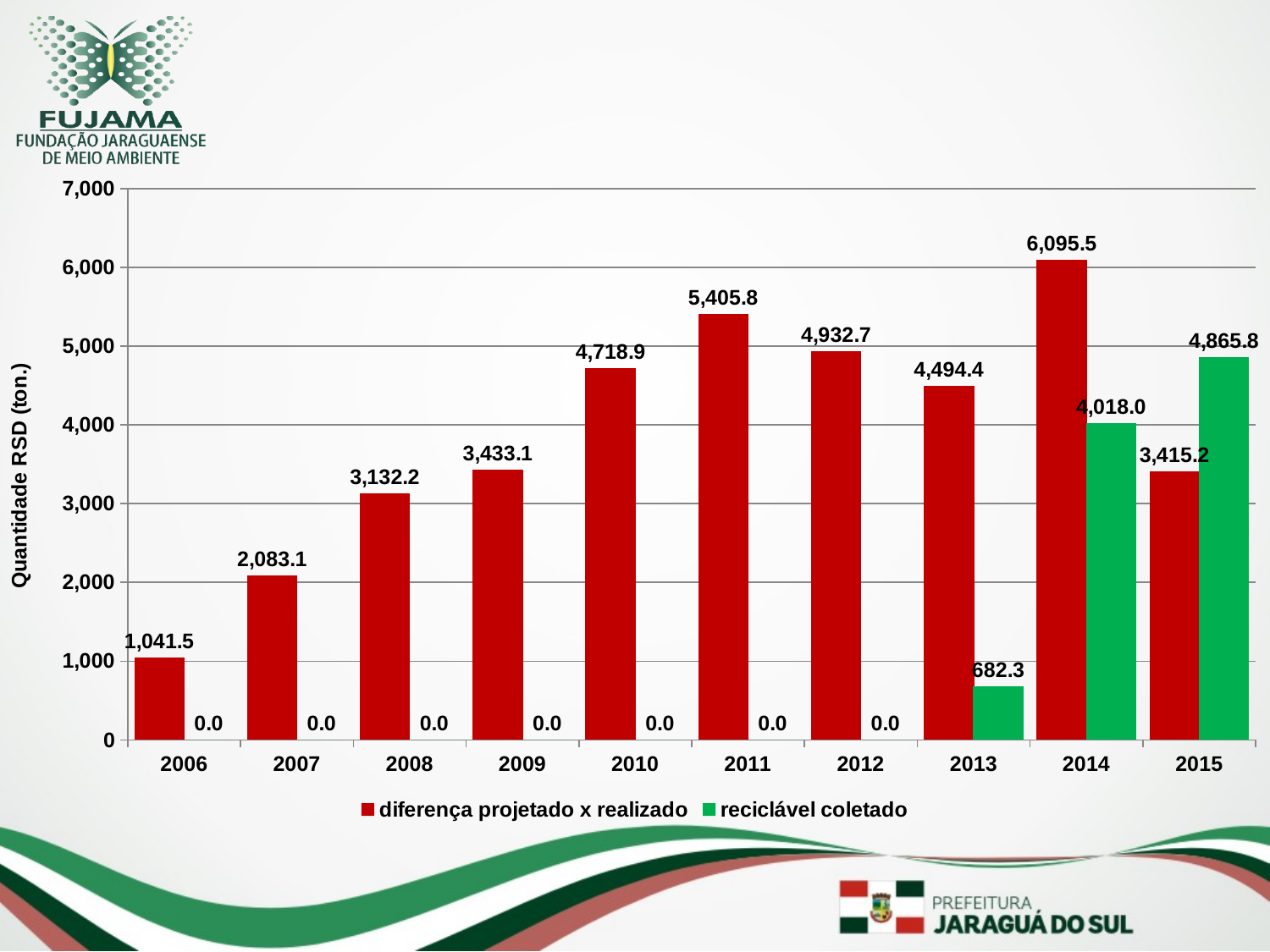
How many series does the legend list? 2 What is the difference between "reciclável coletado" and "diferença projetado x realizado" in 2015? 1,450.6 Is the value of "diferença projetado x realizado" for 2011 greater or less than 5,000? greater What is the value of "reciclável coletado" for 2013? 682.3 Which year has the lowest value for "diferença projetado x realizado"? 2006 What is the difference between "diferença projetado x realizado" and "reciclável coletado" in 2014? 2,077.5 Which year has the highest value for "diferença projetado x realizado"? 2014 What is the value of "diferença projetado x realizado" for 2014? 6,095.5 How many years are shown on the x axis? 10 What is the value of "reciclável coletado" for 2015? 4,865.8 In 2015, which series has the larger value: "diferença projetado x realizado" or "reciclável coletado"? reciclável coletado What kind of chart is shown on the slide? bar chart